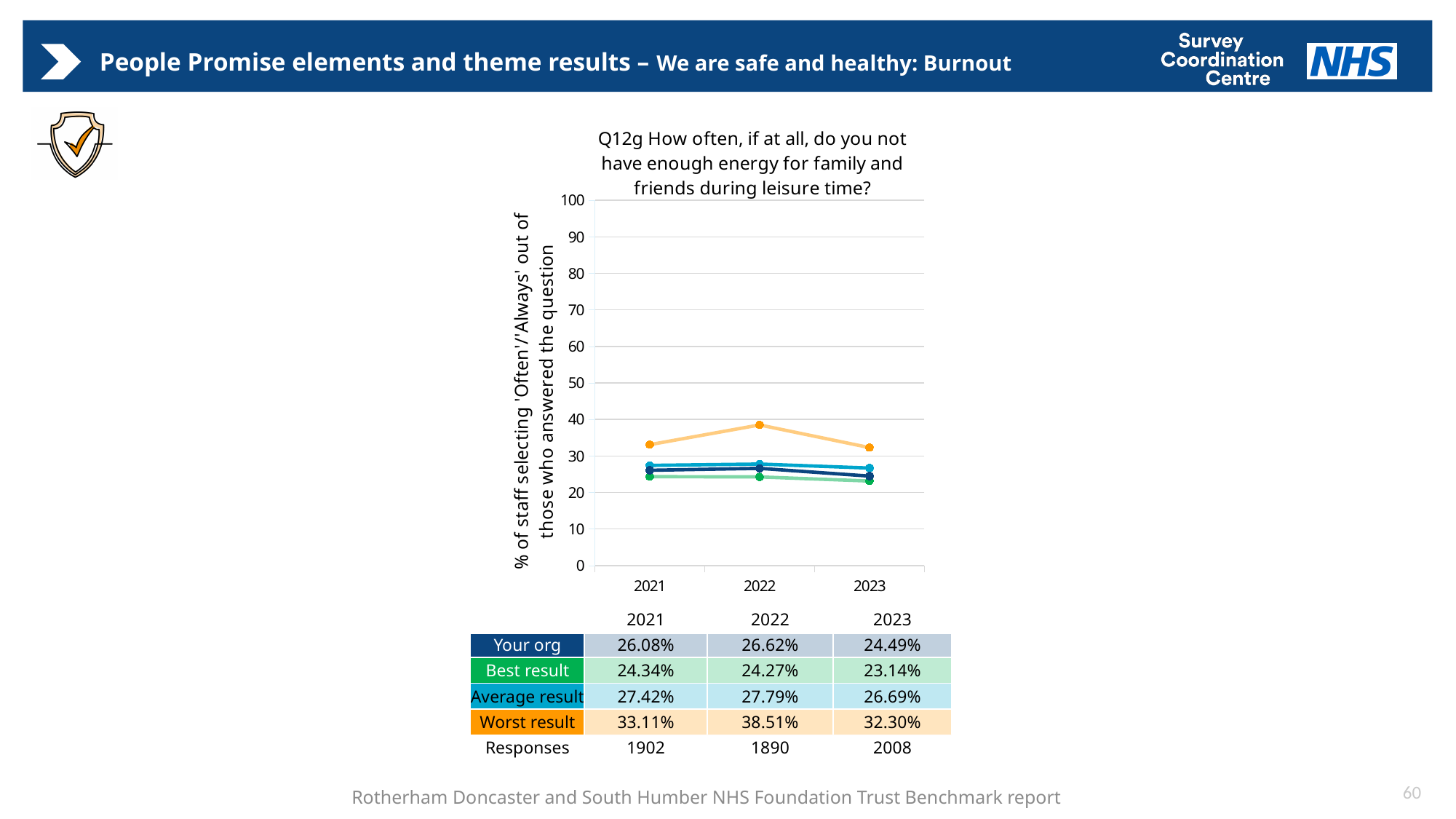
Is the Worst result value for 2022 greater or less than 40? less In which year was the Worst result value highest? 2022 How many responses were recorded in 2023? 2008 Which is larger in 2021: Your org or Average result? Average result What is the value for Your org in 2023? 24.49% What is the difference between the Worst result and Your org values in 2022? 11.89 percentage points How many series are shown in the chart? 4 What is the Average result value in 2021? 27.42% What kind of chart is shown on the slide? line chart How many years are plotted on the x axis? 3 In which year was the Best result value lowest? 2023 What is the Worst result value in 2022? 38.51%